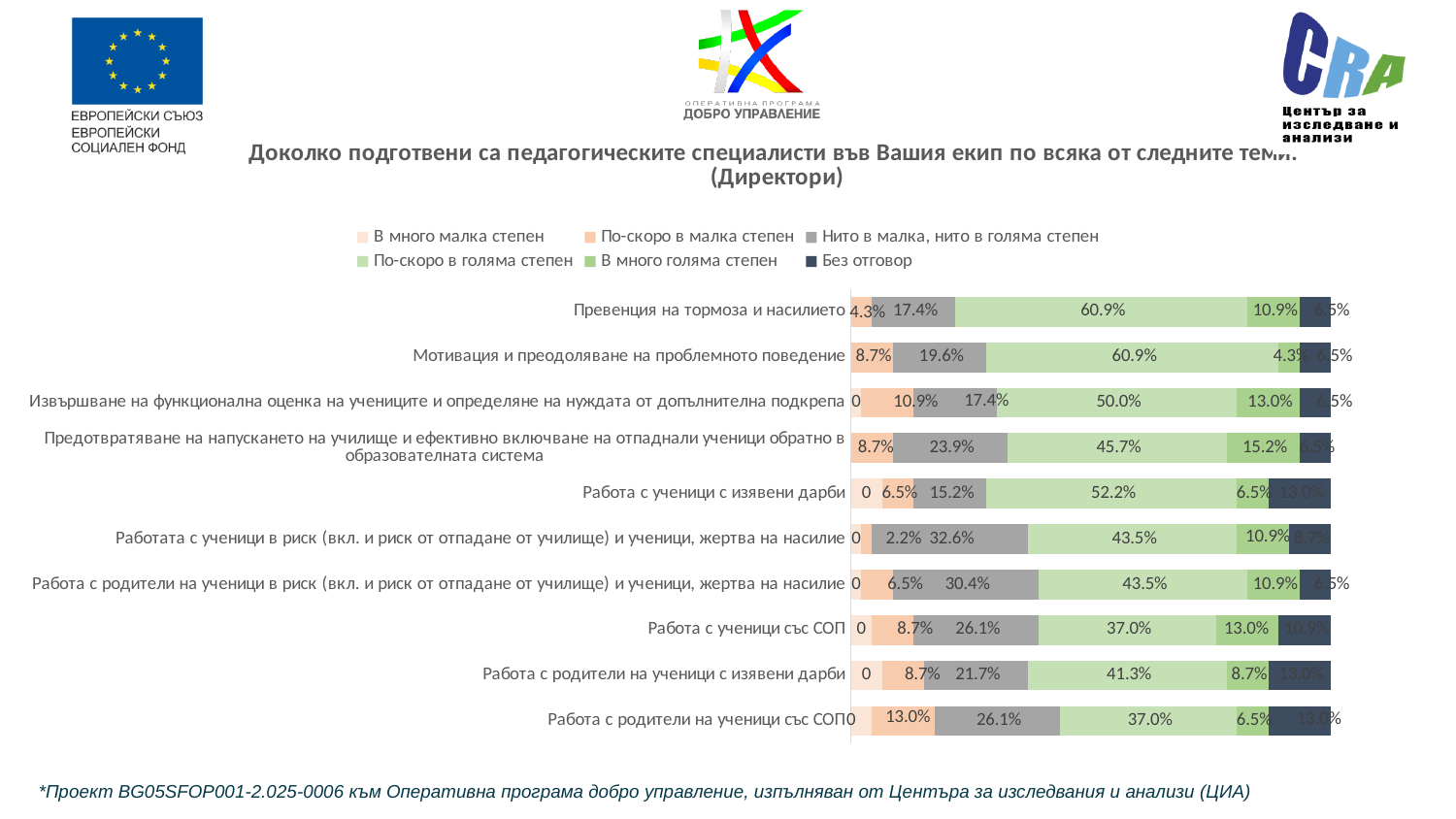
What is the value of 'Нито в малка, нито в голяма степен' for 'Мотивация и преодоляване на проблемното поведение'? 19.6% What is the value of 'По-скоро в голяма степен' for 'Превенция на тормоза и насилието'? 60.9% What is the value of 'В много голяма степен' for 'Предотвратяване на напускането на училище и ефективно включване на отпаднали ученици обратно в образователната система'? 15.2% What is the value of 'По-скоро в голяма степен' for 'Извършване на функционална оценка на учениците и определяне на нуждата от допълнителна подкрепа'? 50.0% What kind of chart is shown on the slide? Stacked bar chart What is the value of 'По-скоро в малка степен' for 'Работа с родители на ученици със СОП'? 13.0% What is the difference between the 'По-скоро в голяма степен' values for 'Превенция на тормоза и насилието' and 'Извършване на функционална оценка на учениците и определяне на нуждата от допълнителна подкрепа'? 10.9 percentage points Which category has the highest value for 'Нито в малка, нито в голяма степен'? Работата с ученици в риск (вкл. и риск от отпадане от училище) и ученици, жертва на насилие Which has the larger 'По-скоро в голяма степен' value: 'Работа с ученици с изявени дарби' or 'Работа с ученици със СОП'? Работа с ученици с изявени дарби How many series does the legend list? 6 How many categories (rows) does the chart show? 10 Which category has the lowest value for 'Нито в малка, нито в голяма степен'? Работа с ученици с изявени дарби